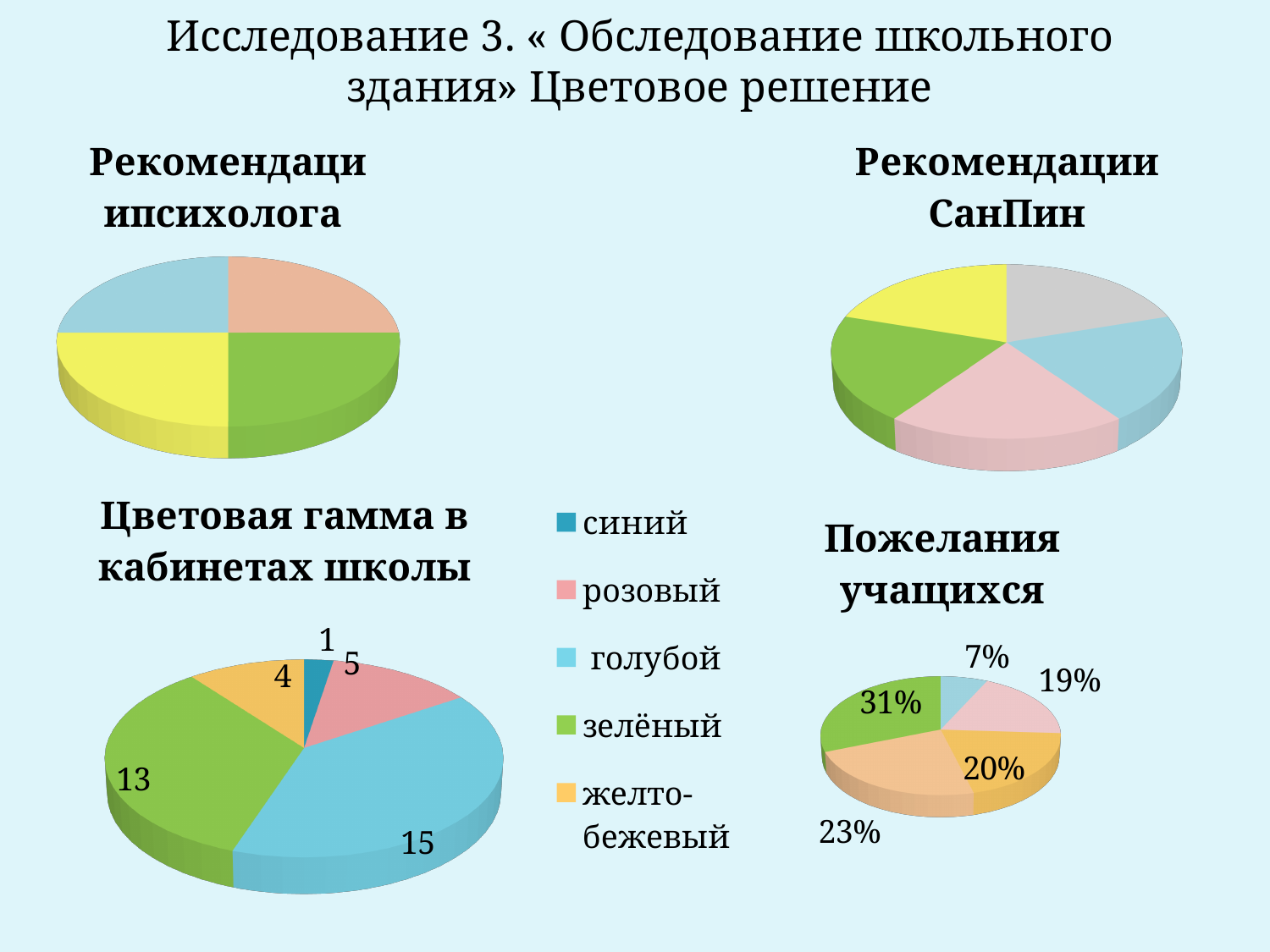
In the chart titled «Цветовая гамма в кабинетах школы», what is the difference between the values for голубой and зелёный? 2 In the chart titled «Цветовая гамма в кабинетах школы», what is the value for зелёный? 13 In the chart titled «Цветовая гамма в кабинетах школы», which colour has the smallest value? синий In the chart titled «Цветовая гамма в кабинетах школы», which colour has the largest value? голубой How many entries does the legend in the middle of the slide list? 5 In the chart titled «Пожелания учащихся», what is the smallest percentage shown? 7% In the chart titled «Цветовая гамма в кабинетах школы», which is larger: the value for розовый or the value for желто-бежевый? розовый In the chart titled «Цветовая гамма в кабинетах школы», what is the value for синий? 1 In the chart titled «Цветовая гамма в кабинетах школы», what is the total of all the slice values? 38 How many slices does the chart titled «Рекомендации СанПин» have? 5 In the chart titled «Цветовая гамма в кабинетах школы», what is the value for голубой? 15 In the chart titled «Пожелания учащихся», what is the largest percentage shown? 31%